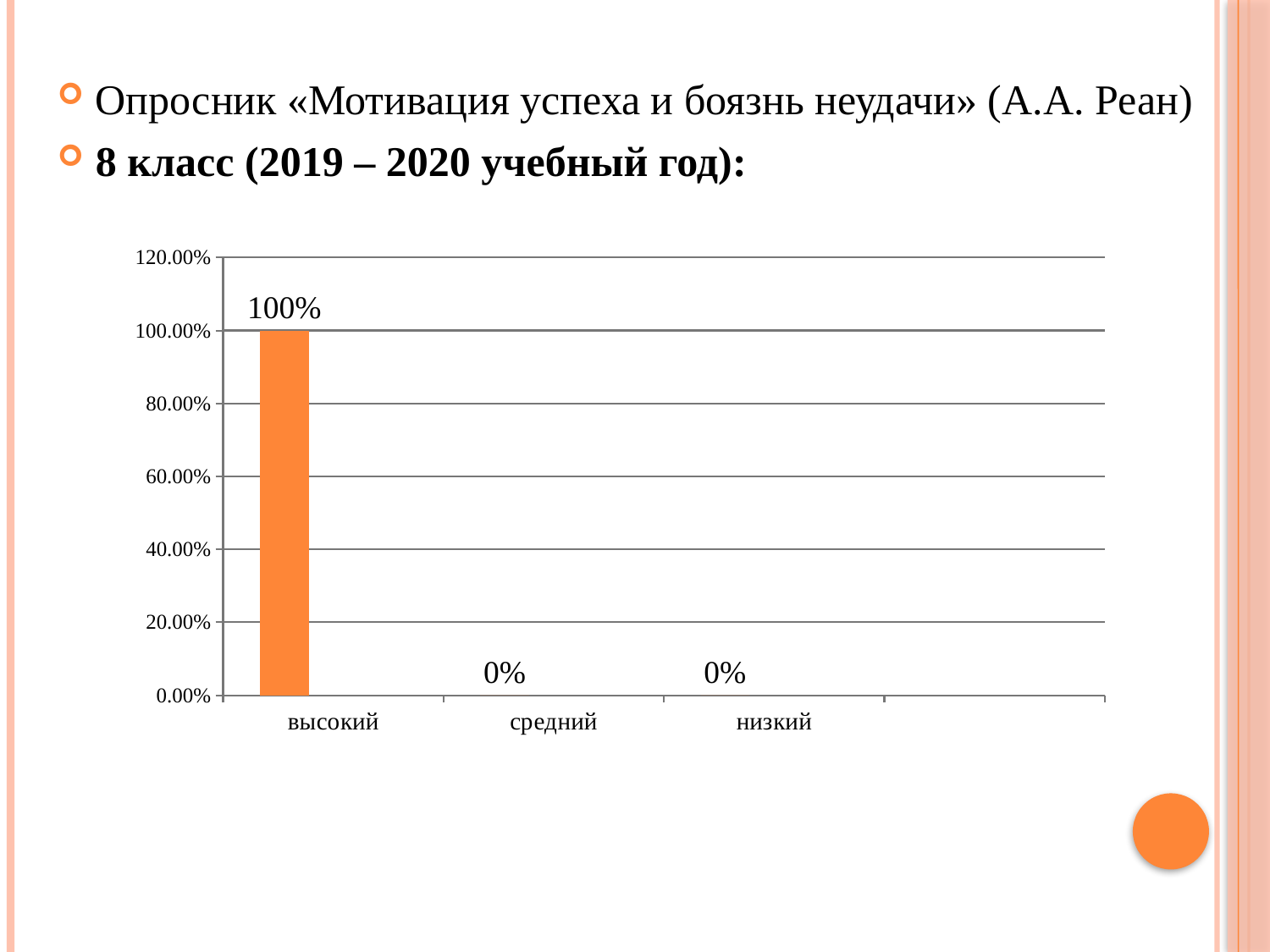
Do the values rise or fall from "высокий" to "средний" along the x axis? fall What is the highest tick value shown on the y axis? 120.00% What kind of chart is shown on the slide? bar chart What is the value for the category "низкий"? 0% Is the value for "высокий" greater or less than 80.00%? greater How many categories are shown on the x axis? 3 What colour is the bar for "высокий"? orange What is the difference between the values for "высокий" and "средний"? 100% Which category has the highest value? высокий Which is larger, the value for "высокий" or the value for "низкий"? высокий What is the value for the category "средний"? 0% What is the value for the category "высокий"? 100%